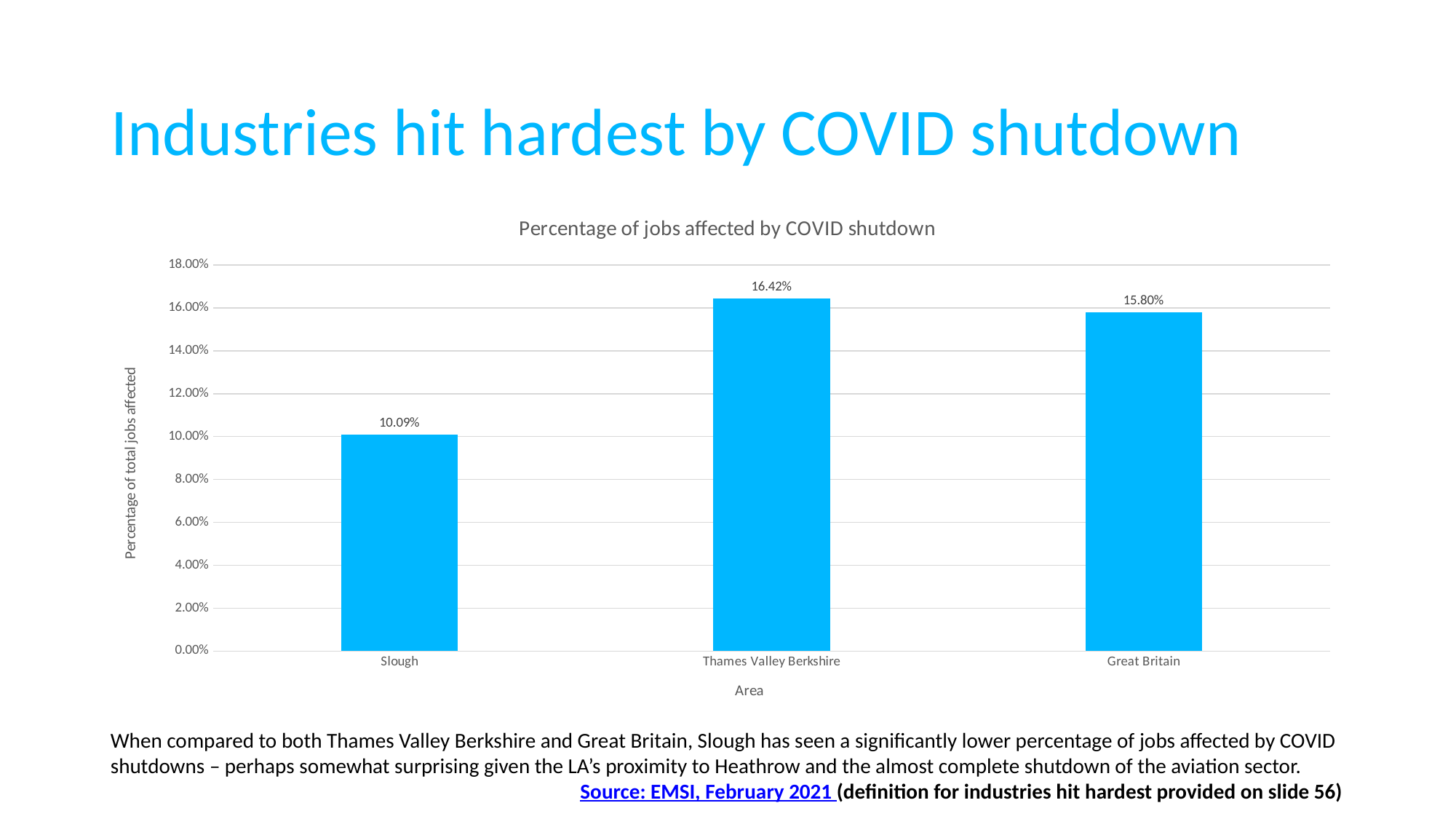
What is the difference between the percentage of jobs affected in Thames Valley Berkshire and in Slough? 6.33% How many areas are shown on the chart? 3 What is the title of the chart? Percentage of jobs affected by COVID shutdown Which has a higher percentage of jobs affected by COVID shutdown, Great Britain or Slough? Great Britain What is the percentage of jobs affected by COVID shutdown for Thames Valley Berkshire? 16.42% Which area has the lowest percentage of jobs affected by COVID shutdown? Slough What is the percentage of jobs affected by COVID shutdown for Slough? 10.09% Which area has the highest percentage of jobs affected by COVID shutdown? Thames Valley Berkshire Is the value for Slough greater or less than 12.00%? less What kind of chart is shown on the slide? Bar chart What is the difference between the percentage of jobs affected in Great Britain and in Slough? 5.71% What is the percentage of jobs affected by COVID shutdown for Great Britain? 15.80%